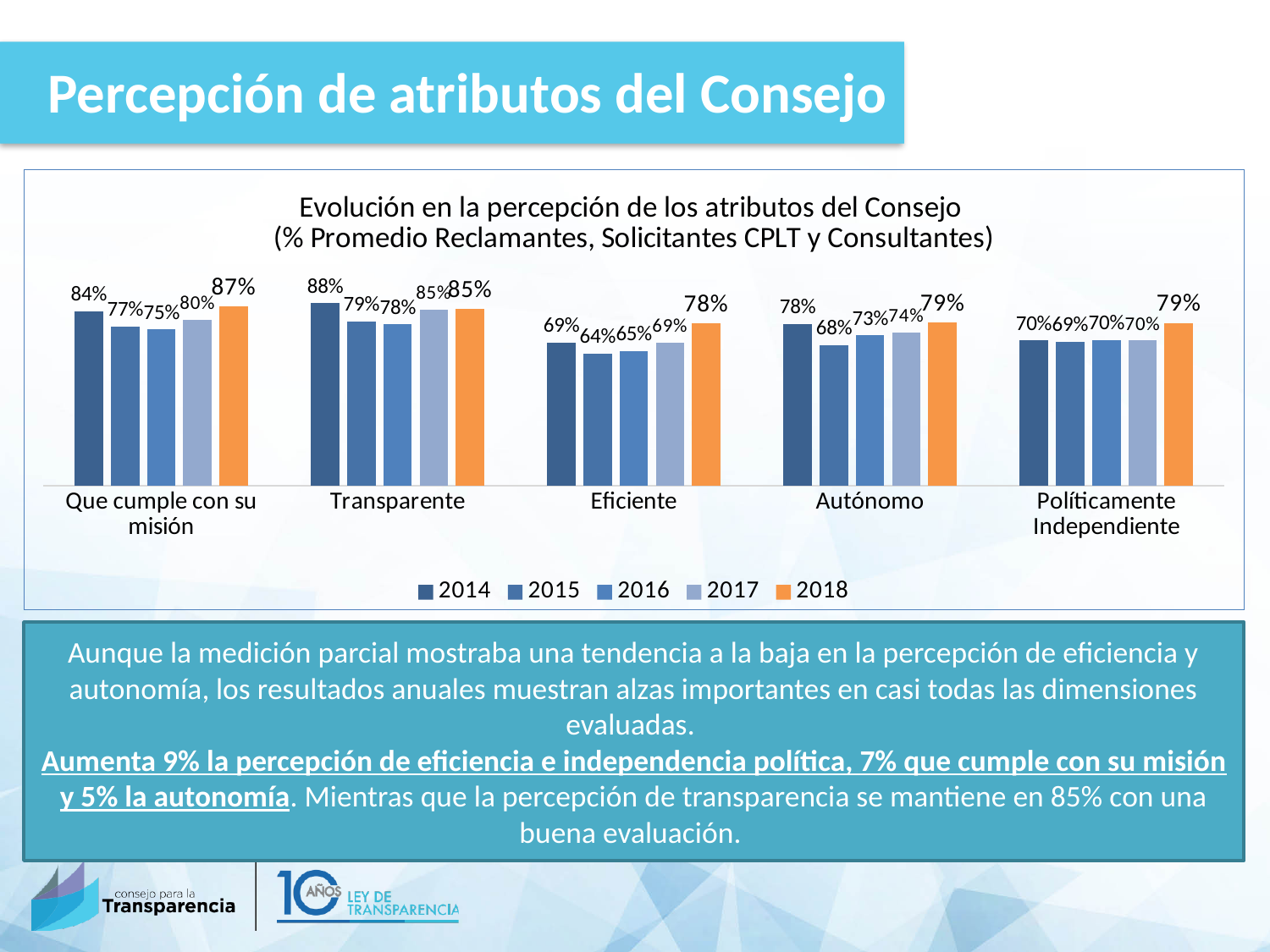
Which category has the lowest value in 2015? Eficiente How many categories are shown on the x axis? 5 What is the value for Eficiente in 2018? 78% What is the value for Políticamente Independiente in 2017? 70% What is the value for Transparente in 2014? 88% What kind of chart is shown? Bar chart What is the difference between the 2018 and 2017 values for Eficiente? 9% What is the value for Autónomo in 2015? 68% Which is larger, the 2014 value for Que cumple con su misión or the 2014 value for Autónomo? Que cumple con su misión Which category has the highest value in 2018? Que cumple con su misión How many series does the legend list? 5 Which year is shown in orange in the legend? 2018